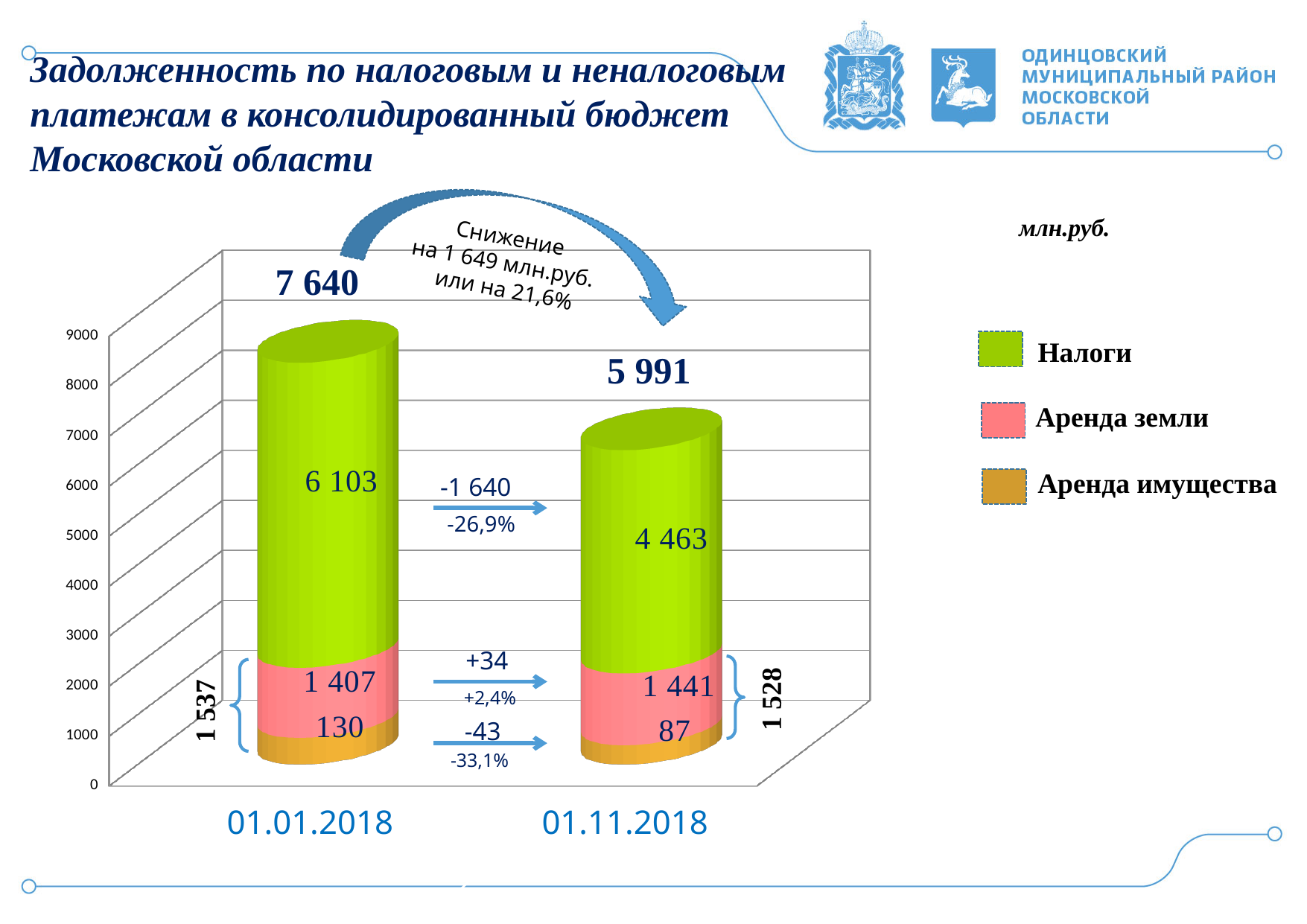
What kind of chart is shown on the slide? Stacked bar chart How many dates (categories) are shown on the x axis? 2 Which colour represents Налоги in the legend? Green What is the value for Налоги on 01.01.2018? 6 103 What is the value for Аренда земли on 01.11.2018? 1 441 Which date has the higher total debt? 01.01.2018 How many series does the legend list? 3 What is the difference between the Налоги values on 01.01.2018 and 01.11.2018? 1 640 What is the value for Аренда имущества on 01.01.2018? 130 Which is larger: Аренда земли on 01.01.2018 or Аренда земли on 01.11.2018? 01.11.2018 What is the total of the stacked bar for 01.11.2018? 5 991 What is the total of the stacked bar for 01.01.2018? 7 640